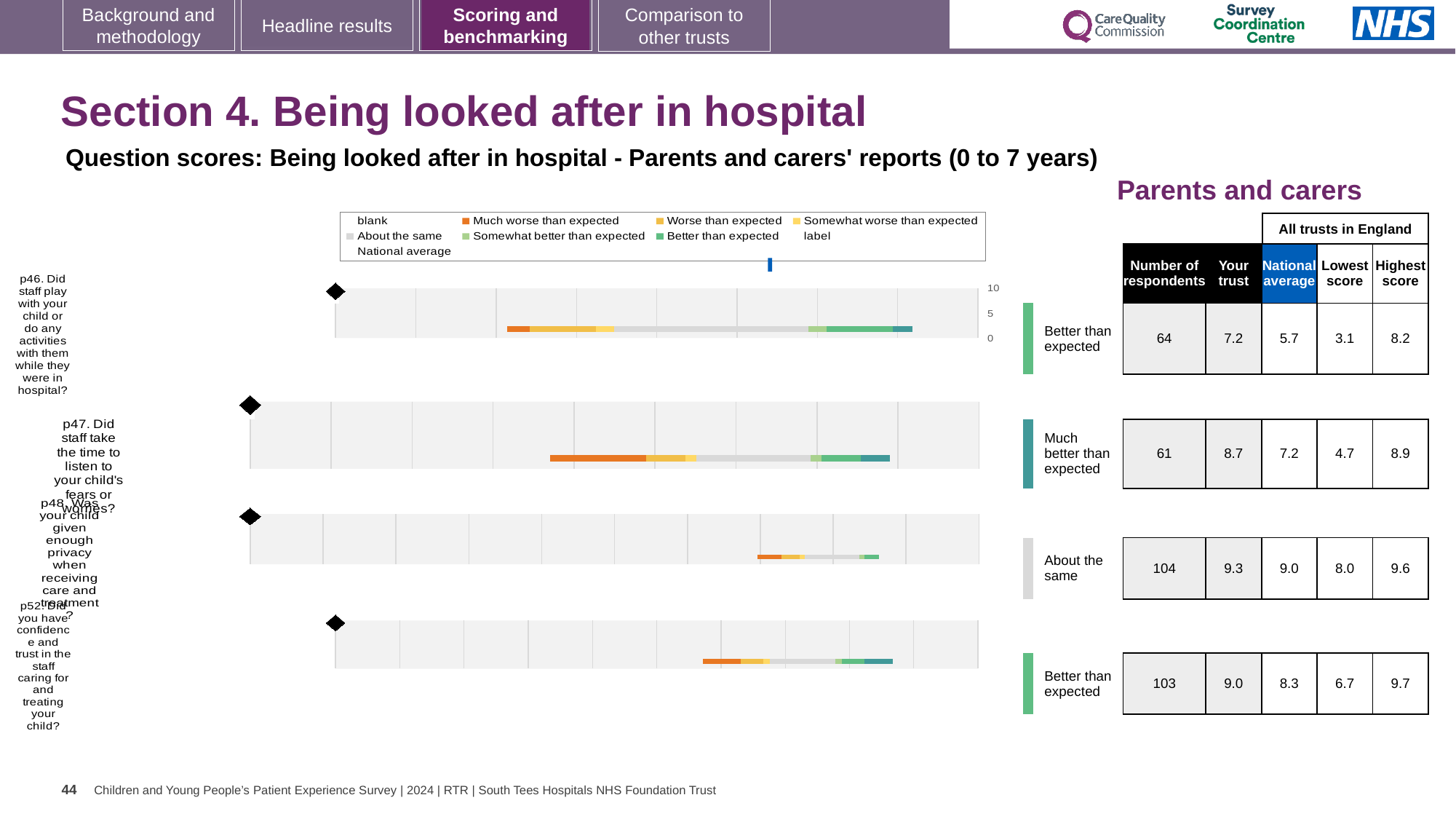
Which question's chart has the lowest Your trust score? p46 For the p46 chart (Did staff play with your child or do any activities with them while they were in hospital?), what is the score for Your trust? 7.2 For the p52 chart (Did you have confidence and trust in the staff caring for and treating your child?), what is the Highest score among all trusts in England? 9.7 How many questions (p46, p47, p48, p52) have a chart on this slide? 4 What benchmark category is shown next to the p47 chart? Much better than expected For the p47 chart, which is larger: the Your trust score or the National average? Your trust For the p48 chart (Was your child given enough privacy when receiving care and treatment?), what is the Number of respondents? 104 Which question's chart has the highest Your trust score? p48 What kind of chart is used to show the distribution of trust scores for each question on this slide? bar chart For the p46 chart, what is the difference between the Your trust score and the National average? 1.5 For the p47 chart (Did staff take the time to listen to your child's fears or worries?), what is the National average score? 7.2 For the p46 chart, is the Your trust score greater or less than 5? greater